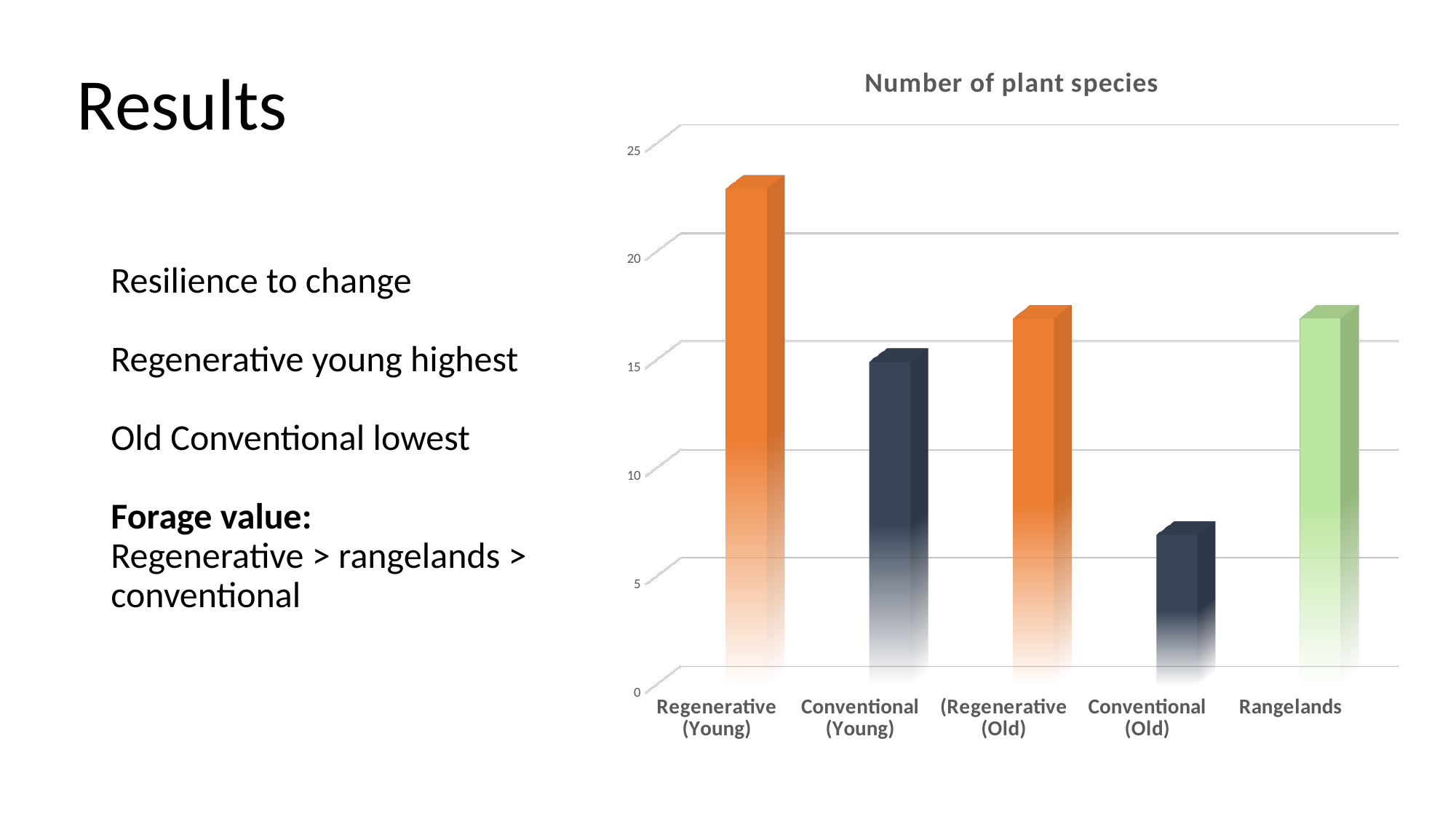
Is the value for Conventional (Old) greater or less than 5? greater What is the title of the chart? Number of plant species What kind of chart is shown on the slide? bar chart What colour is the bar for Rangelands? green Is the value for Regenerative (Old) greater or less than 20? less Is the value for Conventional (Old) greater or less than 10? less Which has more plant species, Regenerative (Young) or Conventional (Young)? Regenerative (Young) How many categories are shown on the x axis of the chart? 5 Which category has the highest number of plant species? Regenerative (Young) Which category has the lowest number of plant species? Conventional (Old)